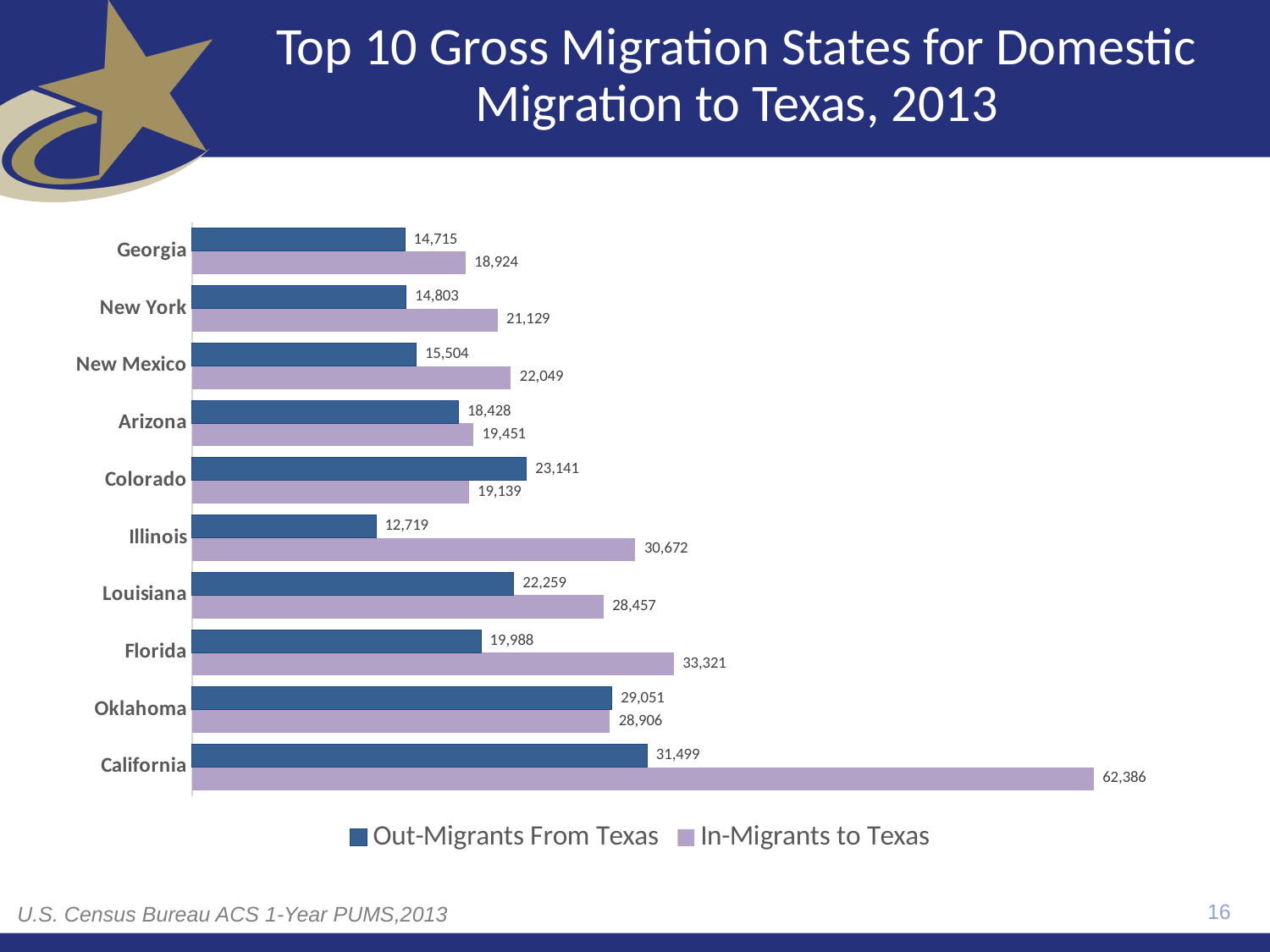
Which state has the lowest value for Out-Migrants From Texas? Illinois What is the difference between In-Migrants to Texas and Out-Migrants From Texas for Florida? 13,333 Which is larger for Colorado: Out-Migrants From Texas or In-Migrants to Texas? Out-Migrants From Texas What is the value for In-Migrants to Texas for Illinois? 30,672 What is the value for Out-Migrants From Texas for Oklahoma? 29,051 What is the value for In-Migrants to Texas for California? 62,386 What is the total of Out-Migrants From Texas and In-Migrants to Texas for Georgia? 33,639 Which series is shown in purple in the legend? In-Migrants to Texas How many series does the legend list? 2 Which state has the highest value for In-Migrants to Texas? California How many states are shown in the chart? 10 What kind of chart is shown on the slide? Bar chart